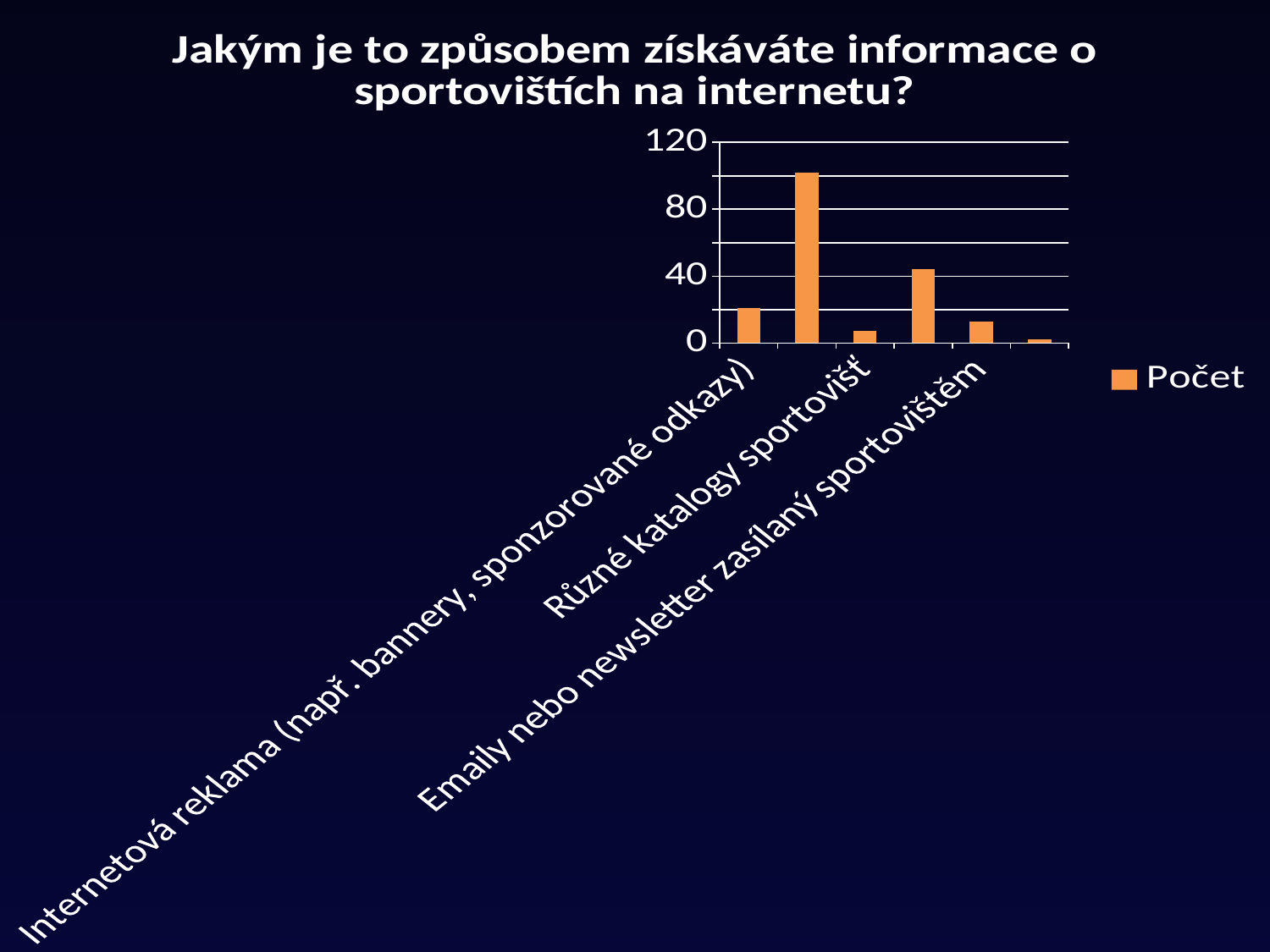
What is the name of the series shown in the legend? Počet What kind of chart is shown on the slide? bar chart Which has the larger value: "Internetová reklama (např. bannery, sponzorované odkazy)" or "Emaily nebo newsletter zasílaný sportovištěm"? Internetová reklama (např. bannery, sponzorované odkazy) Is the value for "Internetová reklama (např. bannery, sponzorované odkazy)" greater or less than 80? less Is the value for "Emaily nebo newsletter zasílaný sportovištěm" greater or less than 40? less How many bars are plotted in the chart? 6 What is the title of the chart? Jakým je to způsobem získáváte informace o sportovištích na internetu? Is the value for "Různé katalogy sportovišť" greater or less than 40? less Which has the larger value: "Internetová reklama (např. bannery, sponzorované odkazy)" or "Různé katalogy sportovišť"? Internetová reklama (např. bannery, sponzorované odkazy) What is the highest value shown on the vertical axis? 120 How many series does the legend list? 1